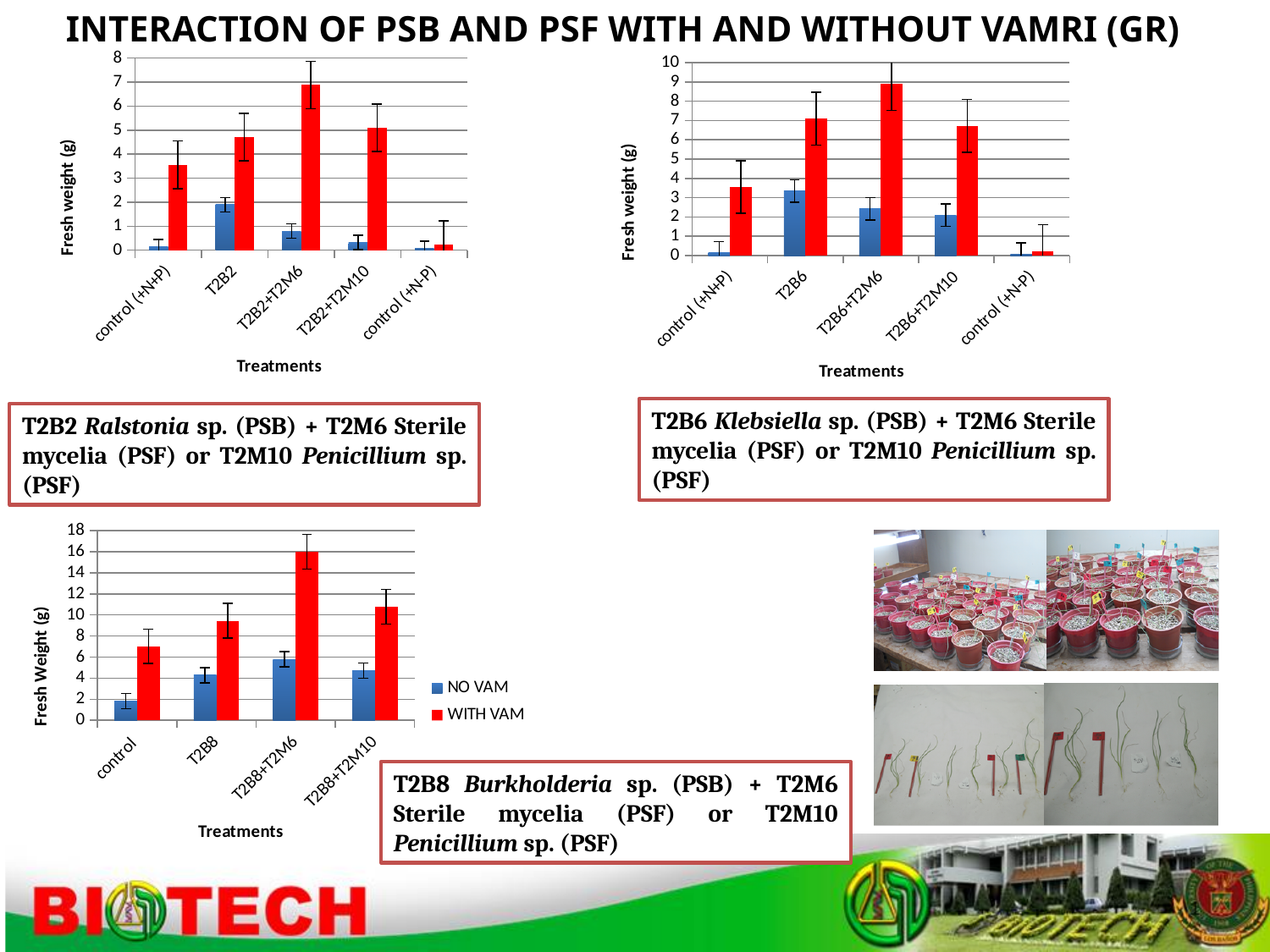
In the top-left chart, is the red-bar value for T2B2+T2M6 greater or less than 6? greater How many treatment categories are shown on the x axis of the bottom-left chart? 4 What is the y-axis label of the bottom-left chart? Fresh Weight (g) What kind of chart is the top-left chart? bar chart In the bottom-left chart, is the WITH VAM value for T2B8+T2M6 greater or less than 14? greater How many series does the legend of the bottom-left chart list? 2 How many treatment categories are shown on the x axis of the top-left chart? 5 In the top-right chart, which treatment has the highest red-bar fresh weight? T2B6+T2M6 In the top-left chart, which treatment has the lowest red-bar fresh weight? control (+N-P) In the bottom-left chart, which treatment has the highest WITH VAM fresh weight? T2B8+T2M6 In the bottom-left chart, which is larger for T2B8: the NO VAM value or the WITH VAM value? WITH VAM In the top-right chart, is the red-bar value for T2B6+T2M6 greater or less than 8? greater